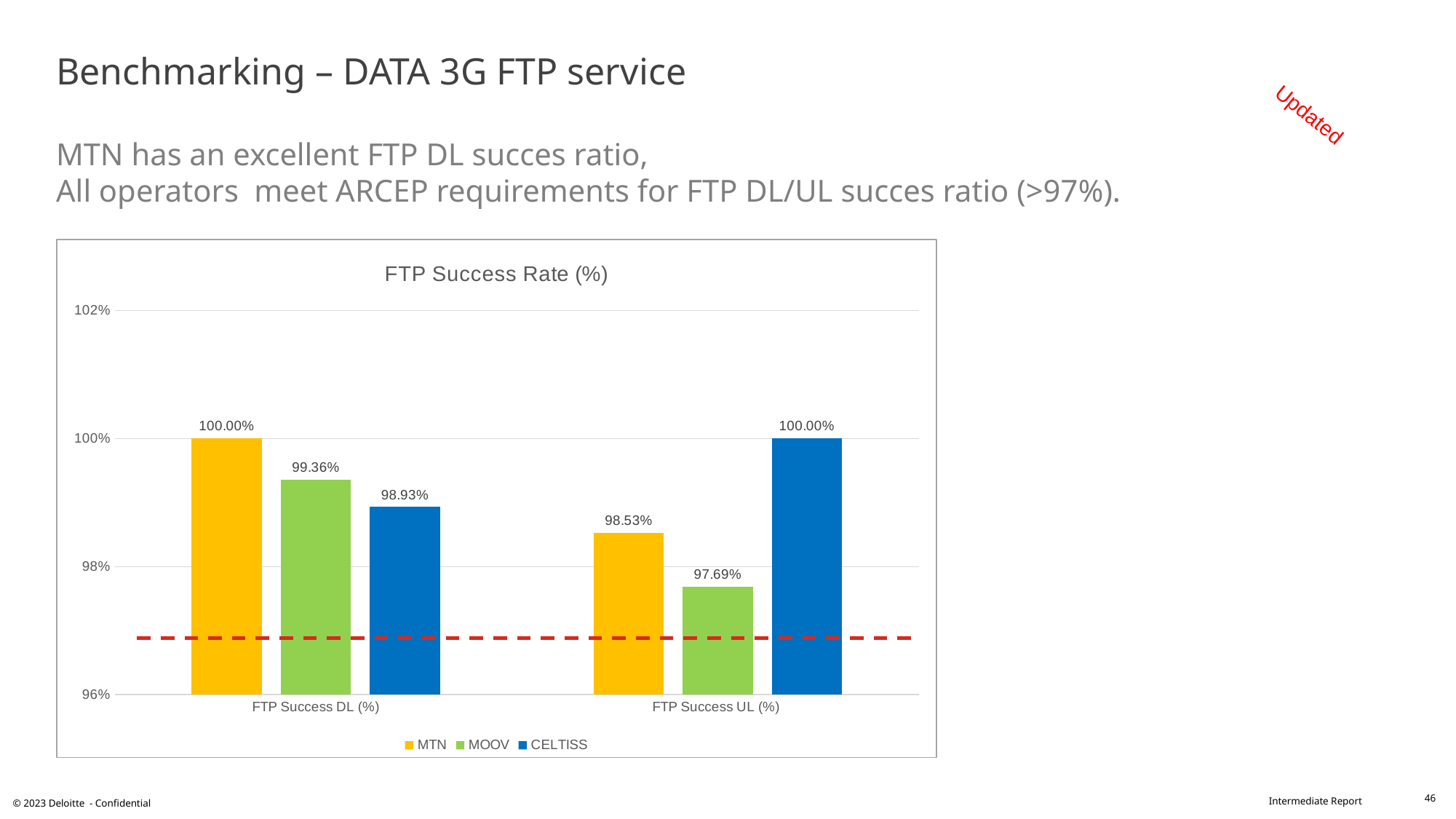
What is the FTP Success DL (%) value for CELTISS? 98.93% What is the FTP Success UL (%) value for MOOV? 97.69% How many series does the legend list? 3 Which operator has the highest FTP Success UL (%)? CELTISS How many categories are shown on the x axis of the chart? 2 Which operator has the lowest FTP Success DL (%)? CELTISS What is the title of the chart? FTP Success Rate (%) Is the FTP Success UL (%) value for MOOV greater or less than 98%? less What is the FTP Success DL (%) value for MTN? 100.00% Which is larger: MTN's FTP Success UL (%) or MOOV's FTP Success UL (%)? MTN's FTP Success UL (%) What is the difference between MOOV's FTP Success DL (%) and FTP Success UL (%)? 1.67% What kind of chart is shown on the slide? Bar chart